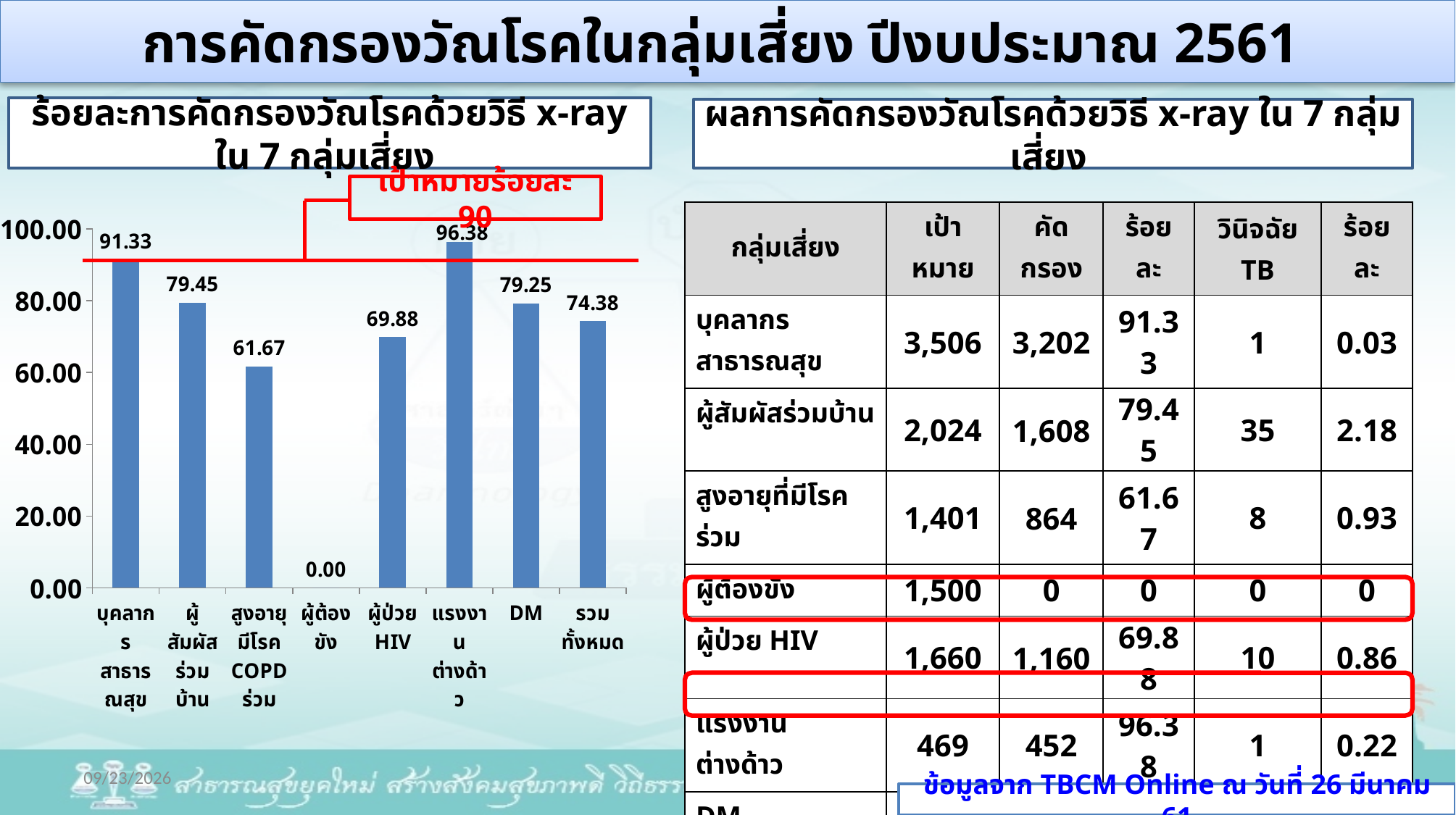
What target percentage does the red horizontal line in the bar chart represent? 90 In the bar chart, what is the value for บุคลากรสาธารณสุข? 91.33 In the bar chart, what is the value for ผู้ป่วย HIV? 69.88 In the bar chart, is the value for สูงอายุมีโรค COPD ร่วม greater or less than 80.00? less How many categories are shown on the x axis of the bar chart? 8 What type of chart is shown on the left of the slide? bar chart In the bar chart, what is the difference between the values for แรงงานต่างด้าว and บุคลากรสาธารณสุข? 5.05 Which category has the lowest value in the bar chart? ผู้ต้องขัง In the bar chart, what is the value for แรงงานต่างด้าว? 96.38 In the bar chart, what is the value for รวมทั้งหมด? 74.38 Which category has the highest value in the bar chart? แรงงานต่างด้าว In the bar chart, which is larger: the value for ผู้สัมผัสร่วมบ้าน or the value for DM? ผู้สัมผัสร่วมบ้าน